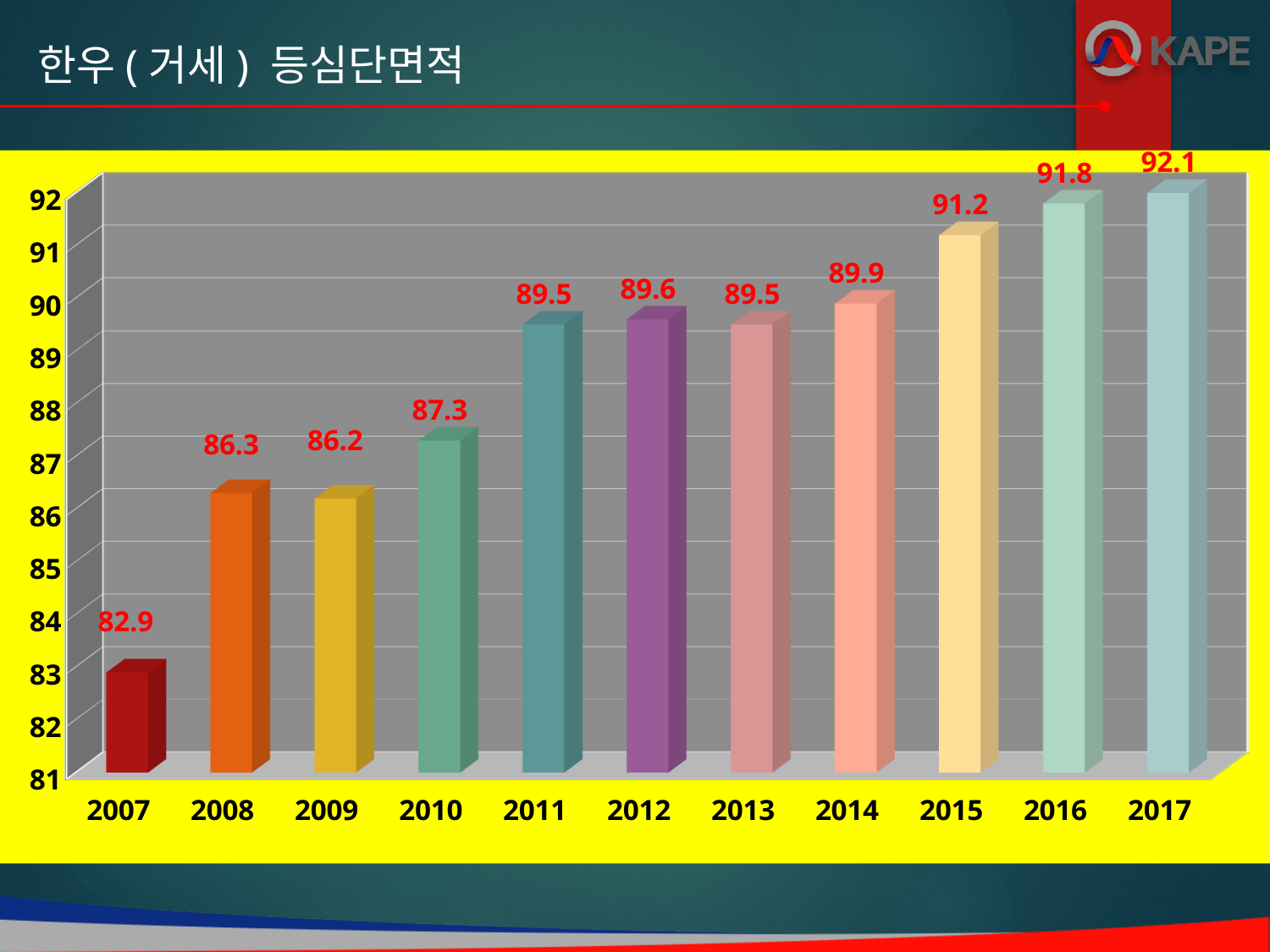
Which is larger, the value for 2008 or the value for 2009? 2008 Do the values generally rise or fall from 2007 to 2017? rise Which year has the highest value? 2017 Which year has the lowest value? 2007 What is the value for 2007? 82.9 What is the value for 2015? 91.2 What is the difference between the values for 2010 and 2009? 1.1 What is the value for 2012? 89.6 How many years are shown on the x axis? 11 What kind of chart is this? bar chart What is the difference between the values for 2017 and 2007? 9.2 Is the value for 2014 greater or less than 89? greater